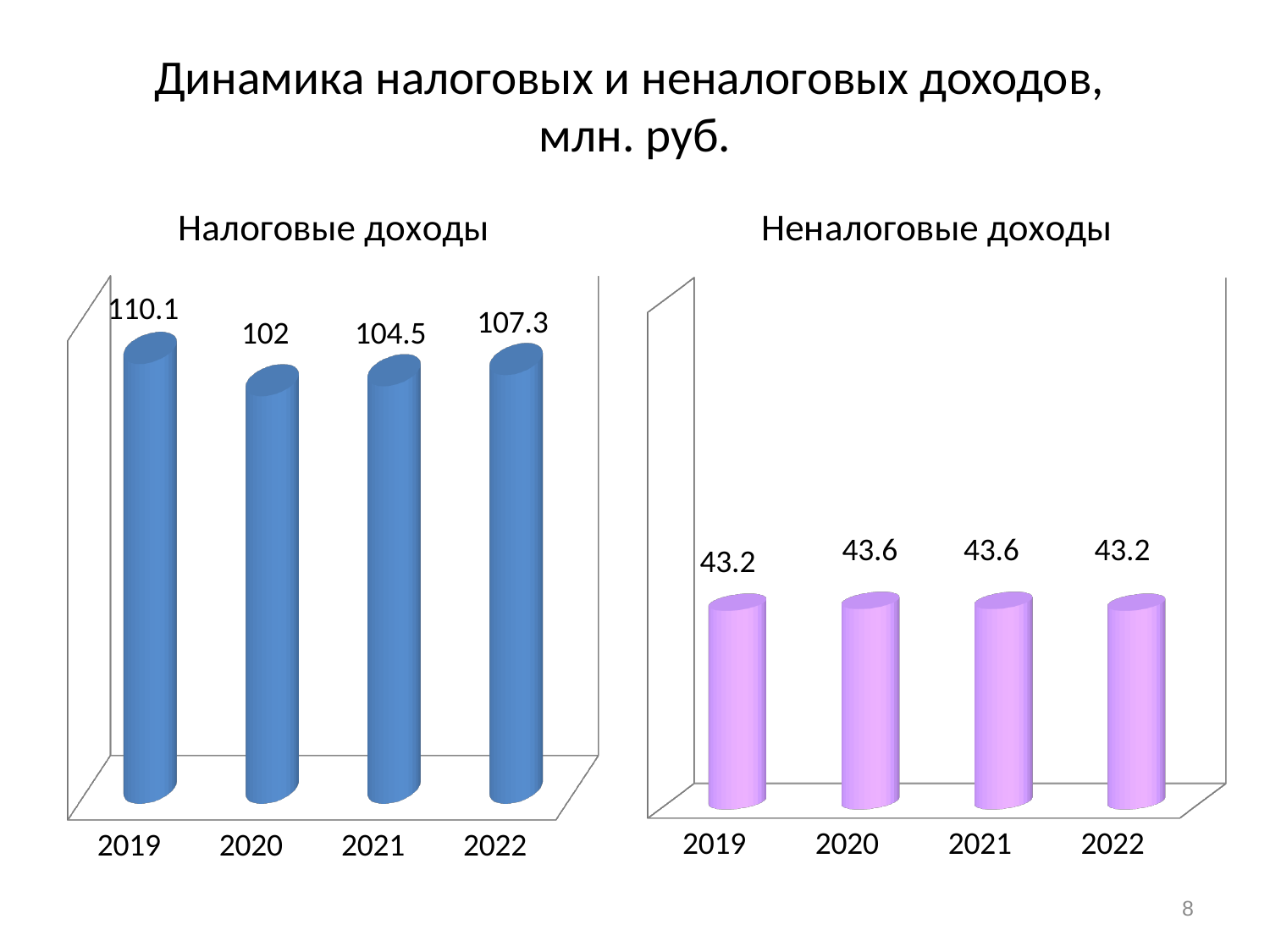
How many years are shown in the 'Неналоговые доходы' chart? 4 In the 'Налоговые доходы' chart, which is larger: the value for 2021 or the value for 2022? 2022 What is the title of the slide? Динамика налоговых и неналоговых доходов, млн. руб. In the 'Неналоговые доходы' chart, what is the difference between the values for 2020 and 2022? 0.4 In the 'Налоговые доходы' chart, which year has the highest value? 2019 In the 'Налоговые доходы' chart, which year has the lowest value? 2020 What type of chart is the 'Налоговые доходы' chart? Bar chart In the 'Налоговые доходы' chart, do the values rise or fall from 2020 to 2022? Rise In the 'Налоговые доходы' chart, what is the value for 2019? 110.1 In the 'Налоговые доходы' chart, what is the difference between the values for 2019 and 2020? 8.1 In the 'Неналоговые доходы' chart, what is the value for 2021? 43.6 In the 'Налоговые доходы' chart, what is the value for 2020? 102